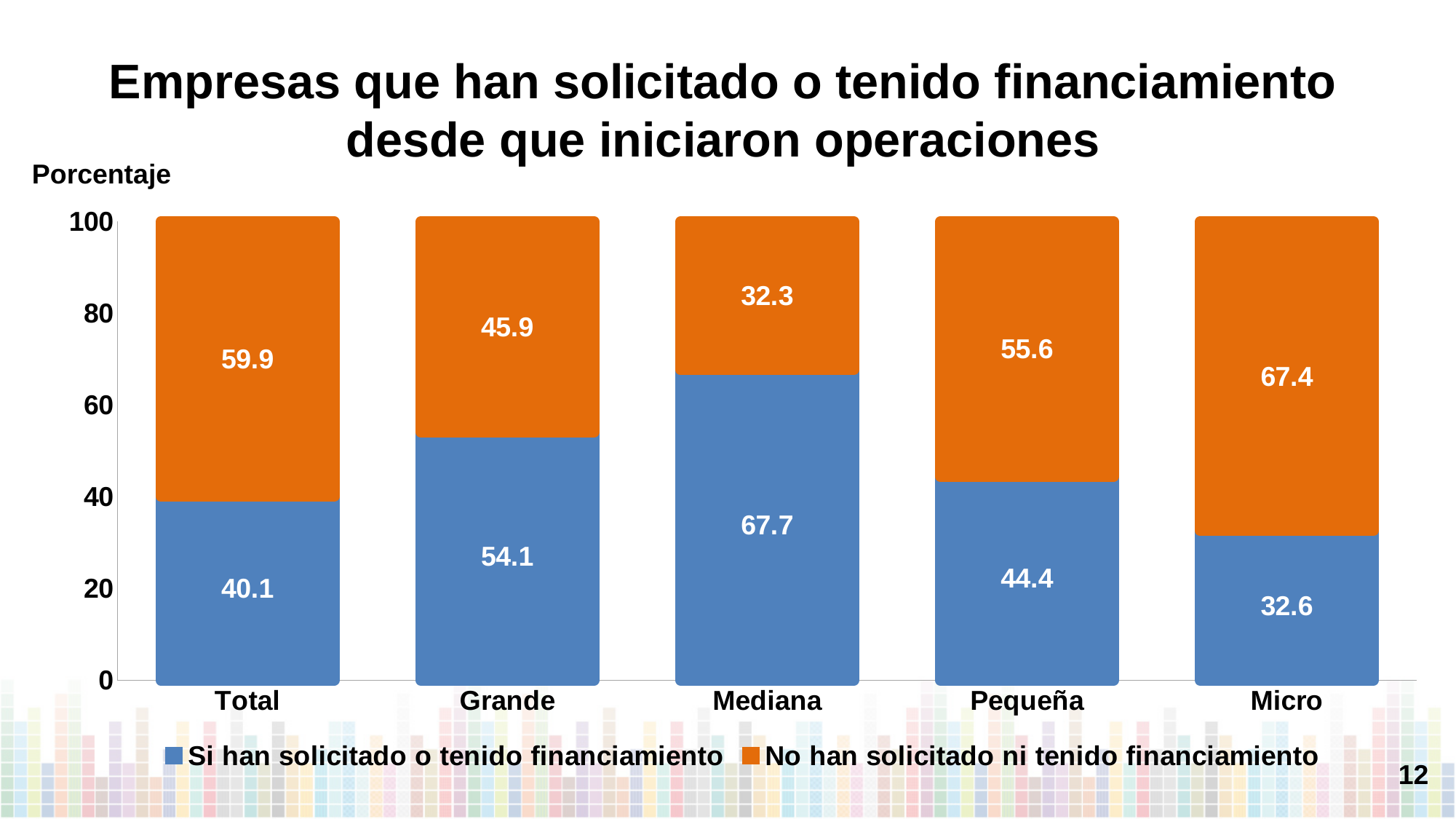
What is the value for 'Si han solicitado o tenido financiamiento' for Total? 40.1 What is the value for 'No han solicitado ni tenido financiamiento' for Micro? 67.4 Which category has the highest value for 'Si han solicitado o tenido financiamiento'? Mediana Which category has the highest value for 'No han solicitado ni tenido financiamiento'? Micro Which is larger: the 'No han solicitado ni tenido financiamiento' value for Grande or for Pequeña? Pequeña What is the value for 'Si han solicitado o tenido financiamiento' for Mediana? 67.7 Which category has the lowest value for 'Si han solicitado o tenido financiamiento'? Micro What kind of chart is shown on the slide? Stacked bar chart What is the total of the stacked bar for Pequeña? 100 What is the difference between the 'Si han solicitado o tenido financiamiento' values for Grande and Pequeña? 9.7 How many categories are shown on the x axis? 5 How many series does the legend list? 2